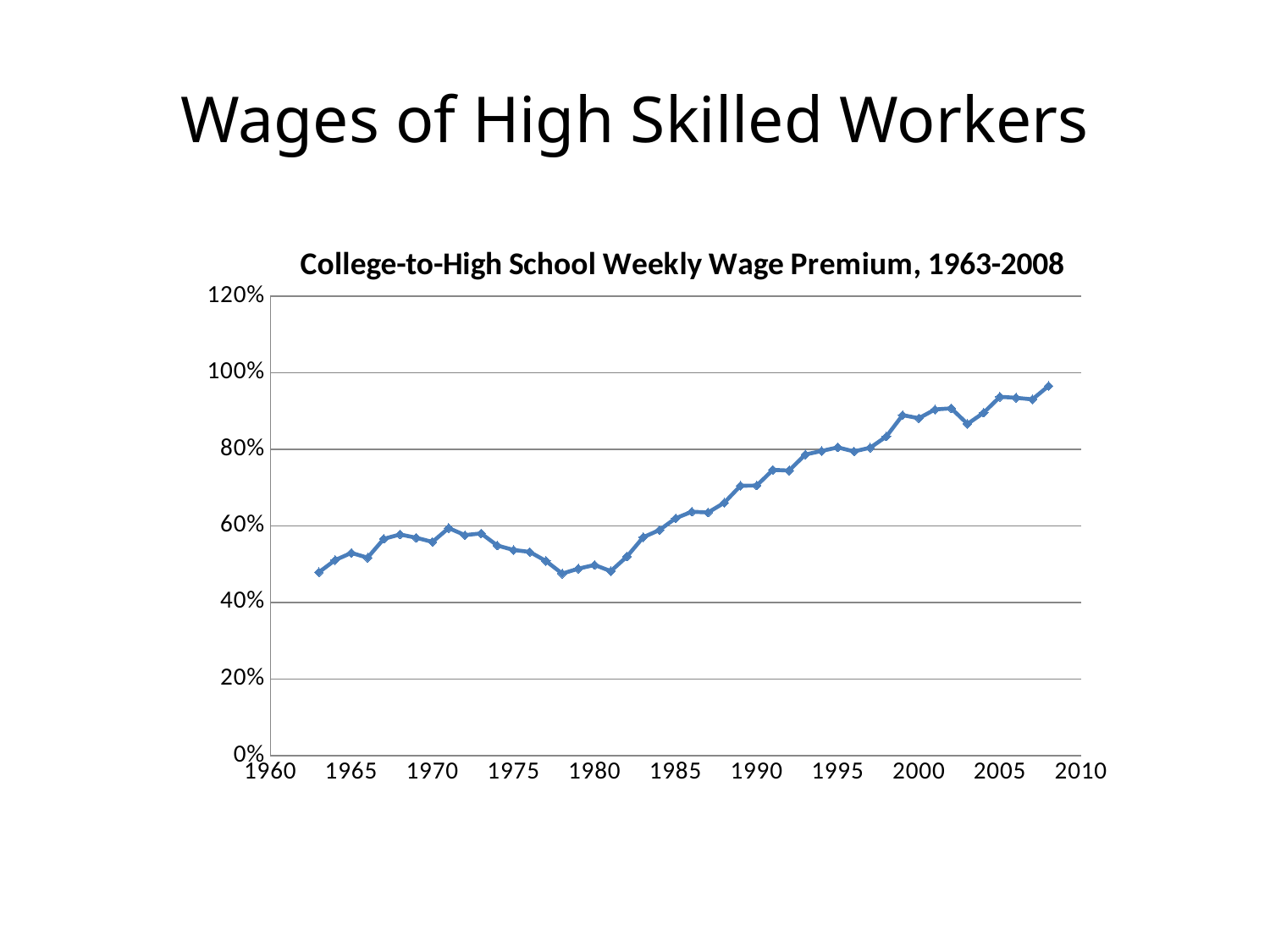
How many lines are plotted on the chart? 1 In which year is the wage premium highest? 2008 Is the wage premium in 1963 greater or less than 60%? less Is the wage premium in 2008 greater or less than 80%? greater Which year has the larger wage premium, 1970 or 1990? 1990 Is the wage premium in 2000 greater or less than 80%? greater Overall, does the wage premium rise or fall from 1963 to 2008? rise Which year has the larger wage premium, 1971 or 1980? 1971 What kind of chart is shown on the slide? line chart What is the title of the chart? College-to-High School Weekly Wage Premium, 1963-2008